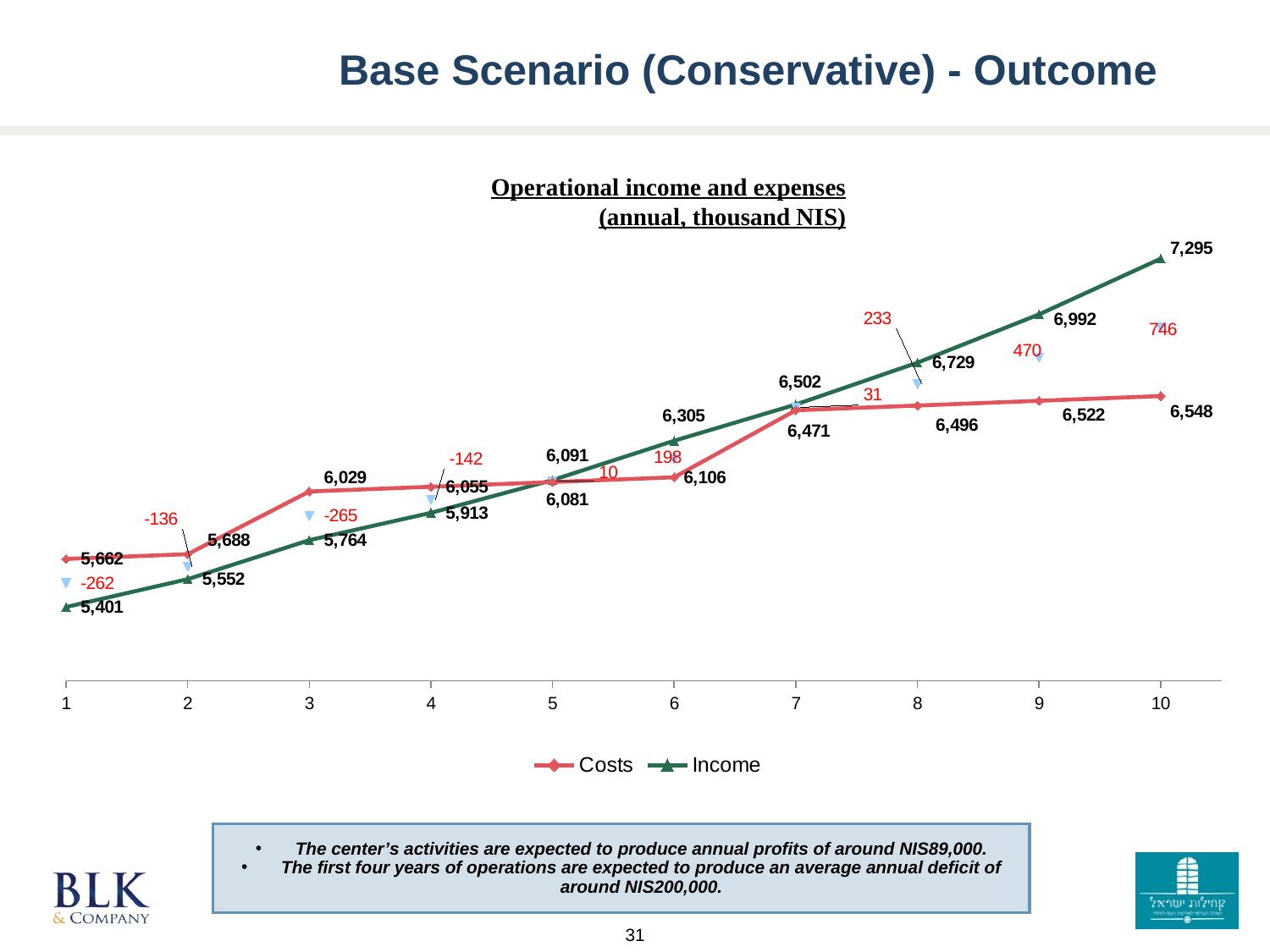
What is the value of Costs in year 7? 6,471 What type of chart is shown? Line chart How many years are shown on the x axis? 10 What is the value of Income in year 10? 7,295 In which year is Income at its lowest? 1 What is the value of Income in year 5? 6,091 What is the difference between Income and Costs in year 10? 747 What is the value of Costs in year 1? 5,662 Which is larger in year 3, Costs or Income? Costs In which year is Costs at its highest? 10 Which is larger in year 9, Costs or Income? Income How many series does the legend list? 2